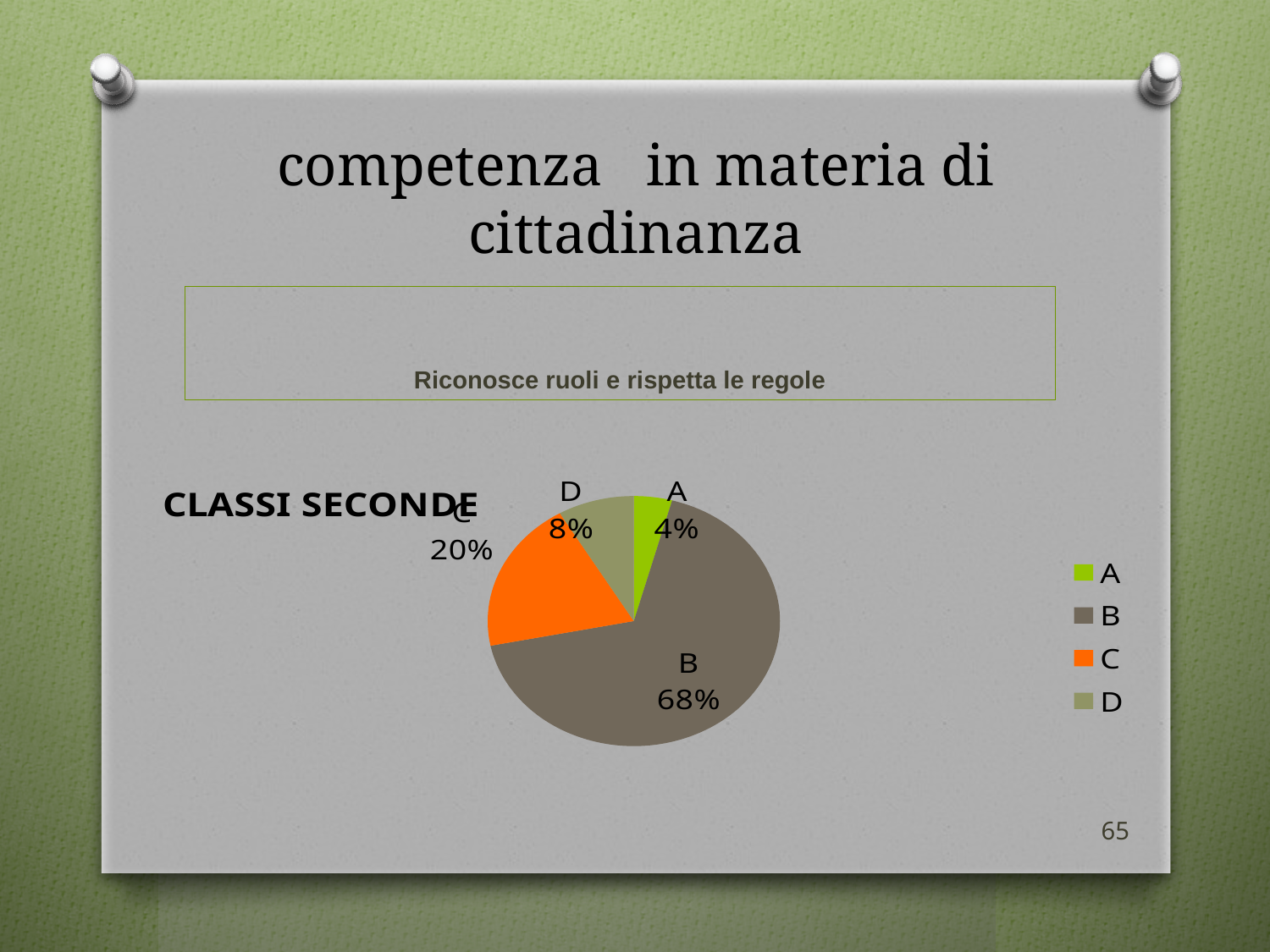
What colour is slice C in the pie chart? orange What percentage does slice D represent in the pie chart? 8% What kind of chart is shown on the slide? pie chart What percentage does slice A represent in the pie chart? 4% How many entries does the legend list? 4 What percentage does slice B represent in the pie chart? 68% What percentage does slice C represent in the pie chart? 20% What is the difference in percentage points between slice B and slice C? 48 Which category has the smallest share of the pie chart? A Which is larger, the share for C or the share for D? C Which category has the largest share of the pie chart? B How many slices does the pie chart have? 4